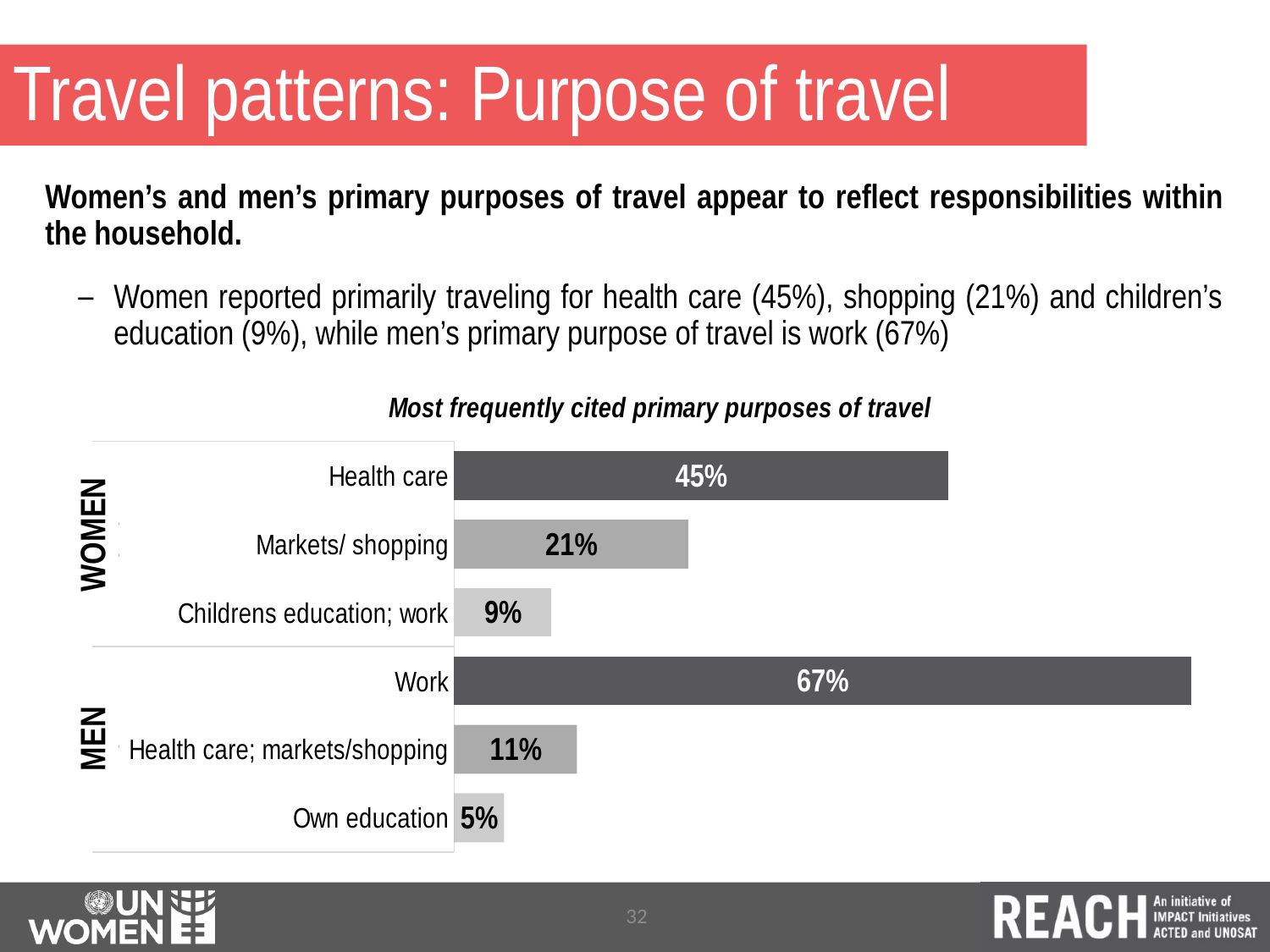
What is the difference between women's 'Markets/ shopping' and 'Childrens education; work' values? 12% Which purpose of travel has the highest value in the chart overall? Work What percentage of men cited work as their primary purpose of travel? 67% What value is shown for 'Own education' in the MEN group? 5% How many bars are plotted in the chart? 6 Which purpose of travel has the lowest value in the chart? Own education What is the difference between the value for men's 'Work' and women's 'Health care'? 22% What percentage of women cited health care as their primary purpose of travel? 45% What value is shown for 'Health care; markets/shopping' in the MEN group? 11% What value is shown for 'Markets/ shopping' in the WOMEN group? 21% What type of chart is shown on the slide? Bar chart Which is larger: women's 'Markets/ shopping' or men's 'Health care; markets/shopping'? Women's 'Markets/ shopping'